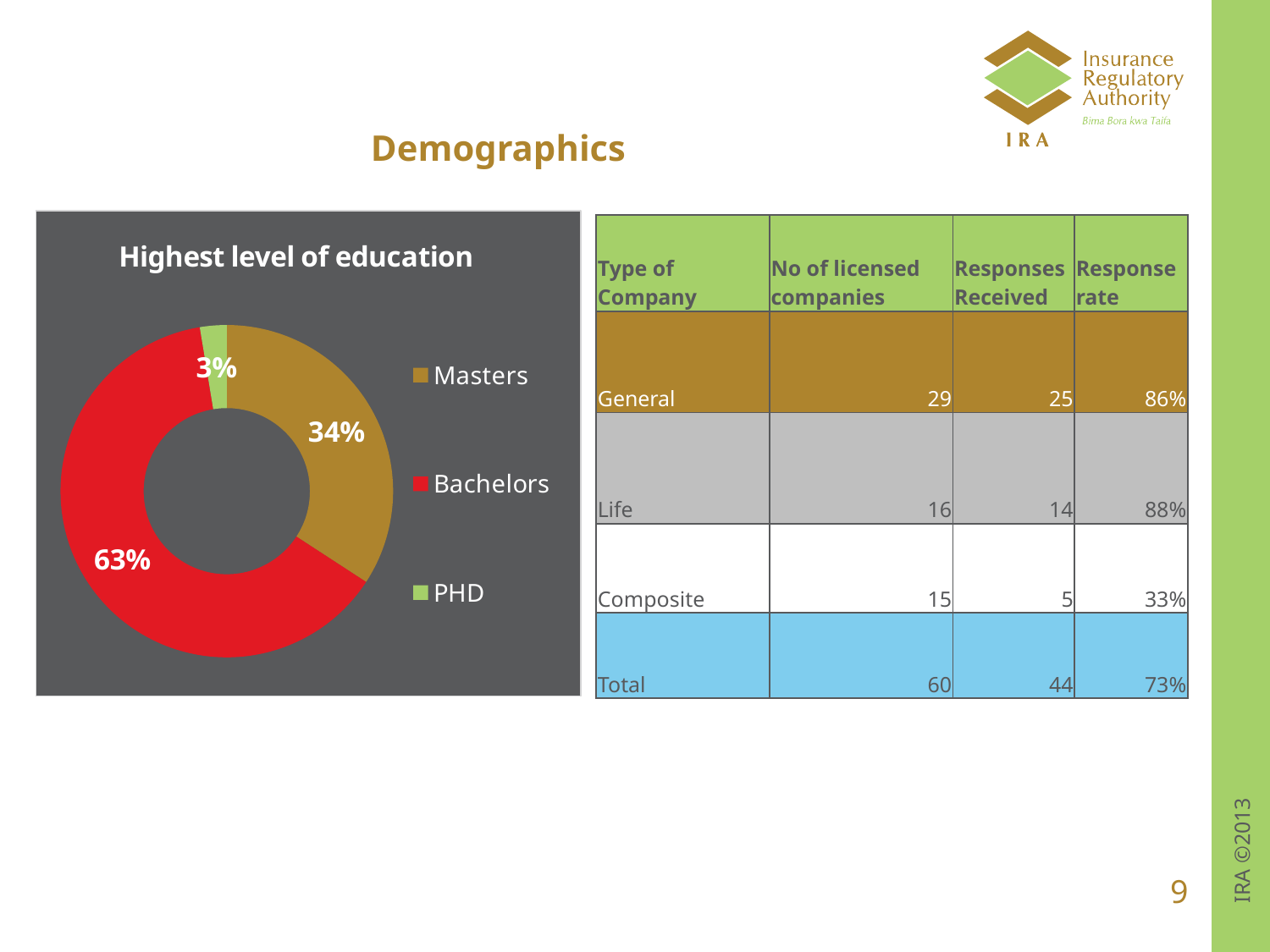
How many categories does the 'Highest level of education' chart show? 3 Which category has the smallest share in the 'Highest level of education' chart? PHD What share of the 'Highest level of education' chart is Masters? 34% What colour represents Bachelors in the 'Highest level of education' chart? Red In the 'Highest level of education' chart, which is larger: Masters or PHD? Masters What is the title of the doughnut chart on the slide? Highest level of education Which category has the largest share in the 'Highest level of education' chart? Bachelors In the 'Highest level of education' chart, what is the difference in percentage points between Bachelors and Masters? 29 What share of the 'Highest level of education' chart is PHD? 3% What kind of chart is 'Highest level of education'? Doughnut chart In the 'Highest level of education' chart, is the share for Masters greater or less than 50%? less What share of the 'Highest level of education' chart is Bachelors? 63%